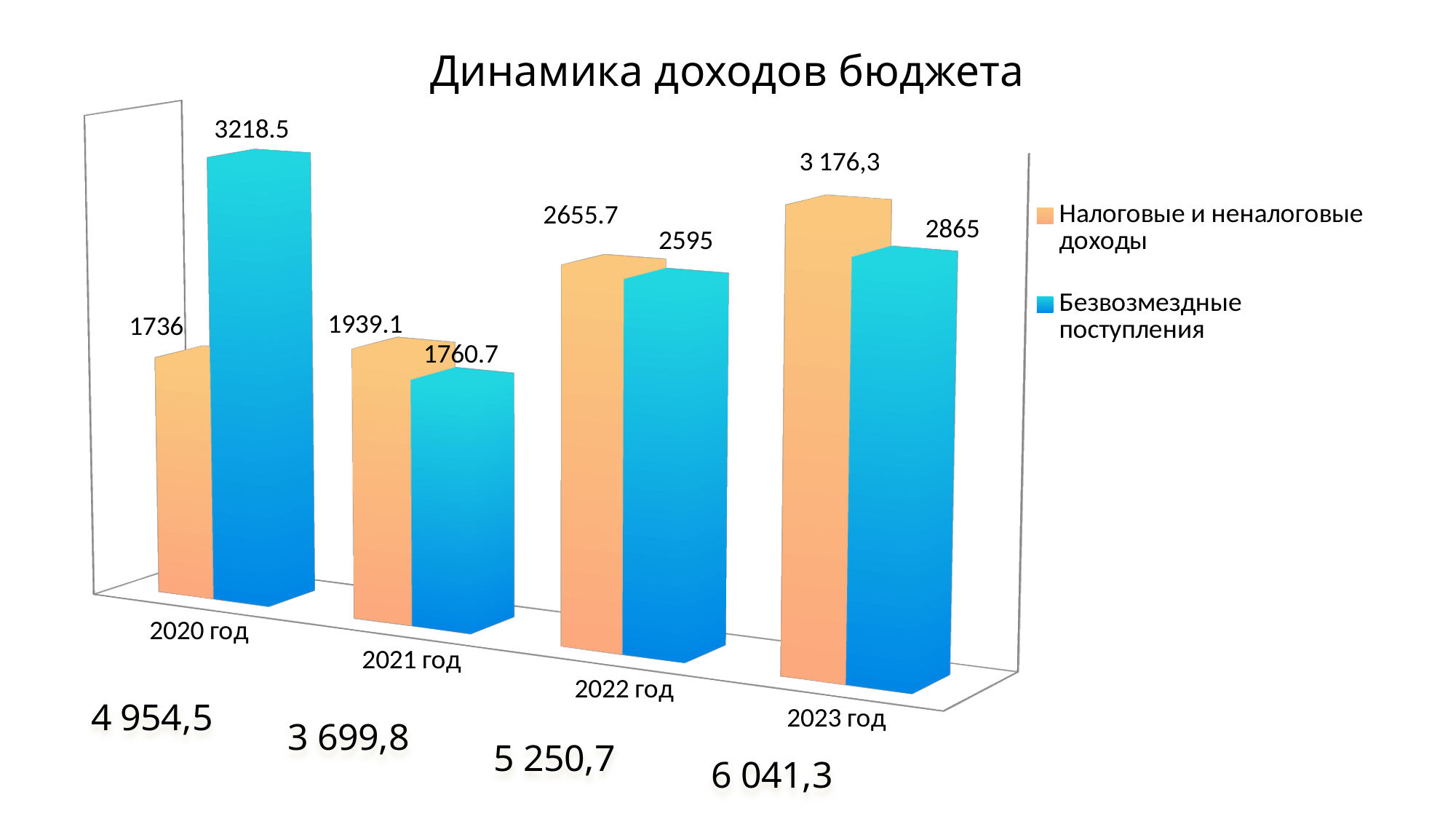
What is the value of Налоговые и неналоговые доходы for 2020 год? 1736 What kind of chart is shown on the slide? Bar chart Do the values for Налоговые и неналоговые доходы rise or fall from 2020 год to 2023 год? Rise What is the value of Безвозмездные поступления for 2021 год? 1760.7 Which is larger in 2021 год: Налоговые и неналоговые доходы or Безвозмездные поступления? Налоговые и неналоговые доходы How many years are shown on the x axis? 4 What is the difference between Безвозмездные поступления and Налоговые и неналоговые доходы in 2020 год? 1482.5 In which year is Безвозмездные поступления highest? 2020 год In which year is Налоговые и неналоговые доходы lowest? 2020 год What is the value of Налоговые и неналоговые доходы for 2023 год? 3 176,3 What is the difference between Налоговые и неналоговые доходы and Безвозмездные поступления in 2023 год? 311.3 How many series does the legend list? 2